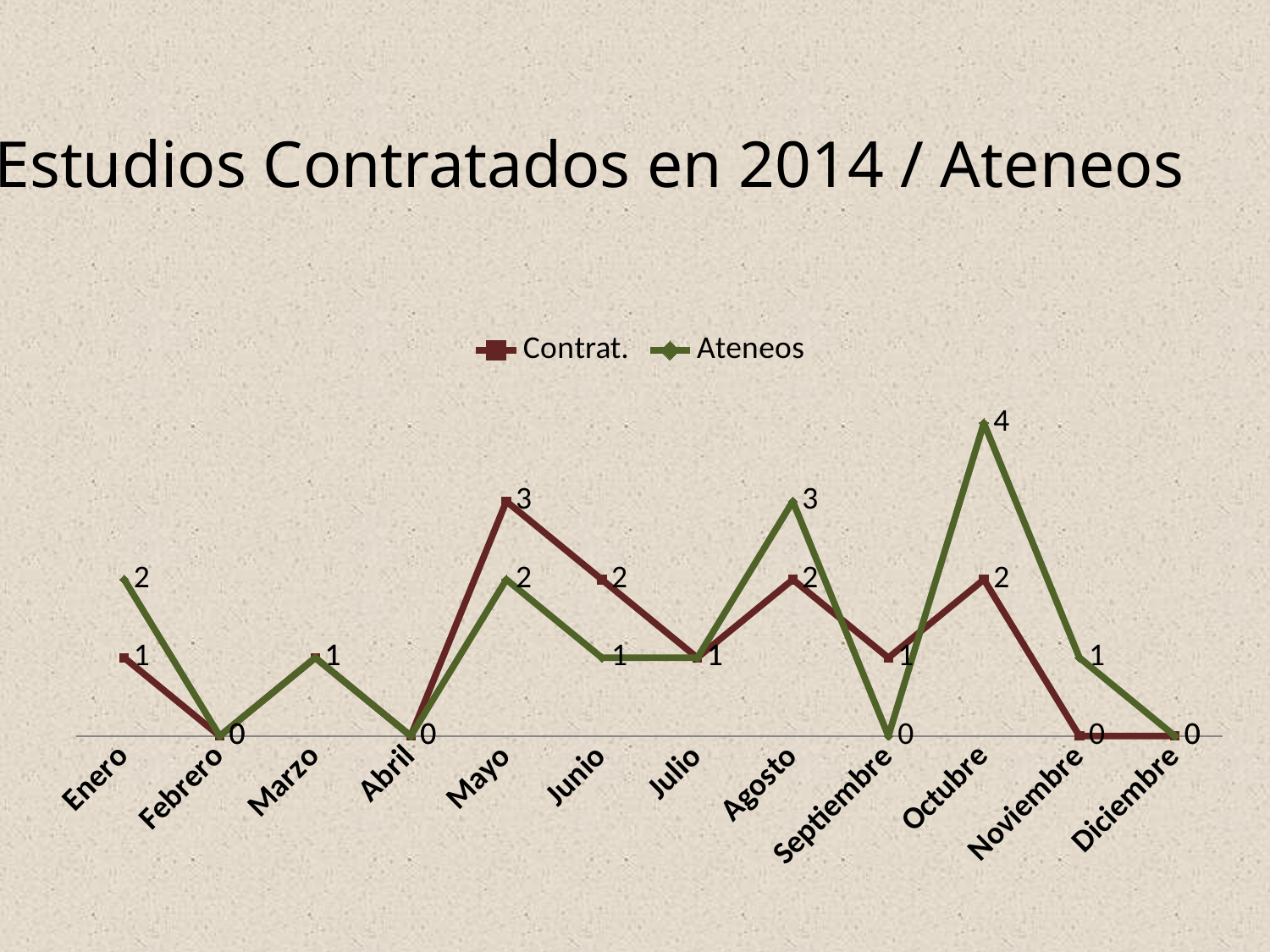
What is the value of Contrat. in Mayo? 3 In which month does the Contrat. series reach its highest value? Mayo How many months are plotted along the x axis? 12 What is the title of the chart? Estudios Contratados en 2014 / Ateneos Does the Contrat. series rise or fall from Octubre to Noviembre? Fall What type of chart is shown on the slide? Line chart How many series does the legend list? 2 What is the value of Ateneos in Enero? 2 In which month does the Ateneos series reach its highest value? Octubre What is the value of Ateneos in Octubre? 4 What is the difference between Ateneos and Contrat. in Octubre? 2 Which series has the larger value in Agosto, Contrat. or Ateneos? Ateneos